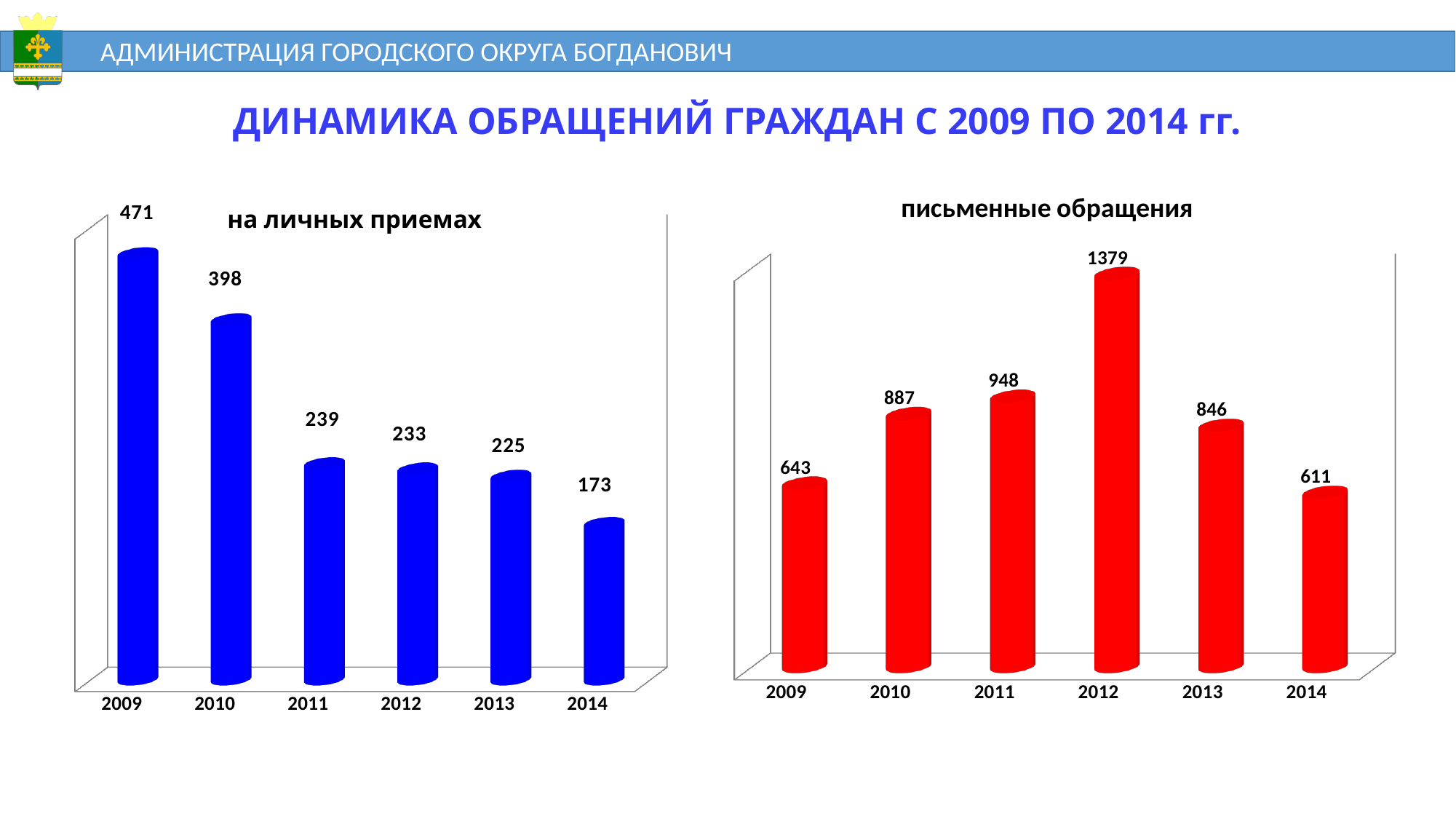
In the chart titled 'на личных приемах', do the values rise or fall from 2009 to 2014? fall What kind of chart is the chart titled 'письменные обращения'? bar chart In the chart titled 'на личных приемах', what is the value for 2009? 471 In the chart titled 'письменные обращения', which is larger, the value for 2010 or the value for 2011? 2011 In the chart titled 'письменные обращения', which year has the lowest value? 2014 In the chart titled 'письменные обращения', what is the difference between the values for 2012 and 2013? 533 In the chart titled 'на личных приемах', what is the difference between the values for 2009 and 2014? 298 In the chart titled 'на личных приемах', which year has the lowest value? 2014 How many years are shown on the x axis of the chart titled 'на личных приемах'? 6 In the chart titled 'письменные обращения', which year has the highest value? 2012 What colour are the bars in the chart titled 'письменные обращения'? red In the chart titled 'письменные обращения', what is the value for 2012? 1379